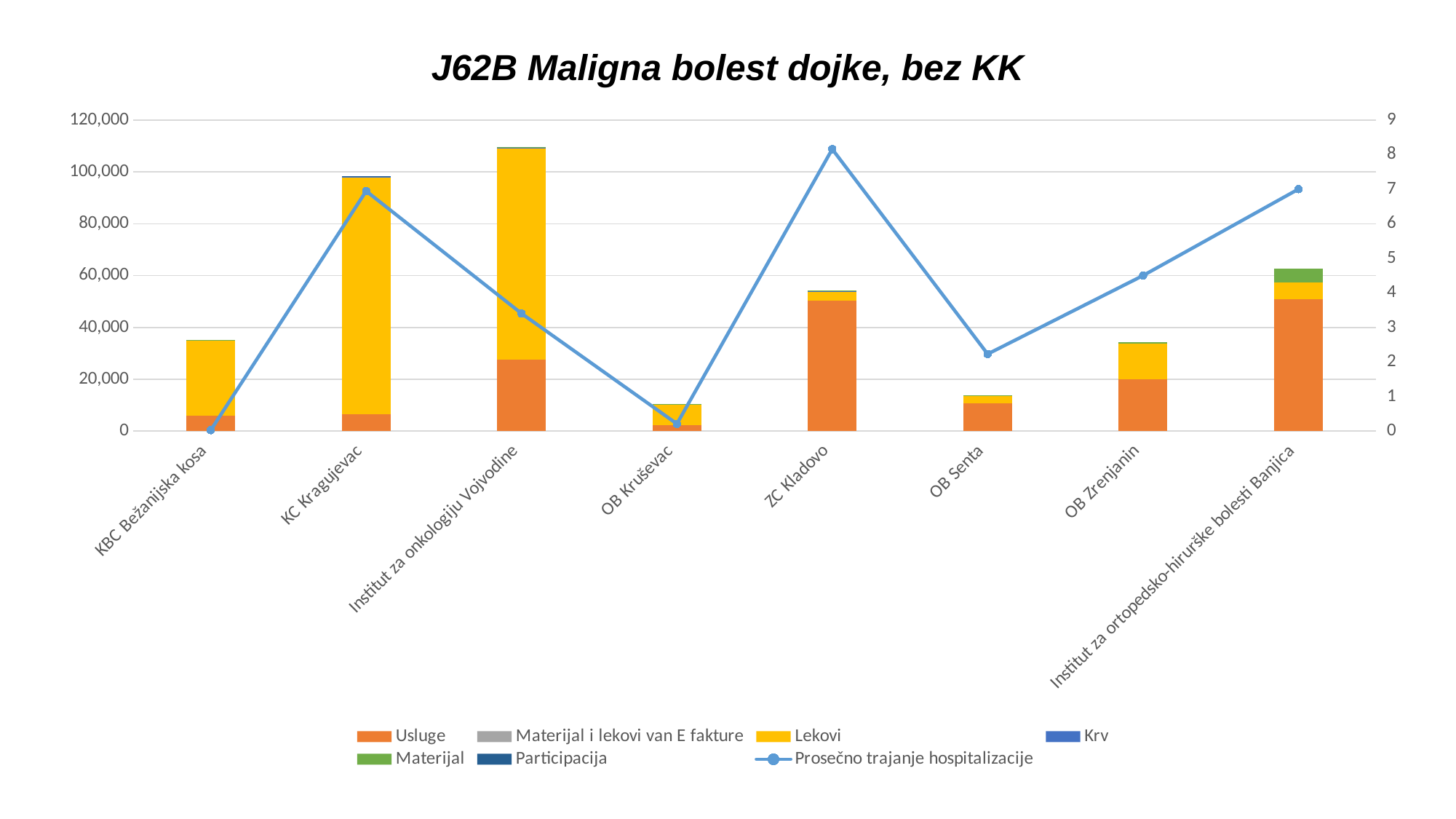
Which has the larger Usluge segment, ZC Kladovo or KC Kragujevac? ZC Kladovo What is the title of the chart? J62B Maligna bolest dojke, bez KK Is the Prosečno trajanje hospitalizacije value for ZC Kladovo greater or less than 7? greater How many categories (institutions) are shown on the x axis? 8 Is the total stacked bar for KC Kragujevac greater or less than 80,000? greater Which institution has the tallest stacked bar? Institut za onkologiju Vojvodine Which institution has the lowest value on the Prosečno trajanje hospitalizacije line? KBC Bežanijska kosa Which institution has the shortest stacked bar? OB Kruševac Which institution has the highest value on the Prosečno trajanje hospitalizacije line? ZC Kladovo Is the total stacked bar for OB Senta greater or less than 20,000? less How many series does the legend list? 7 What kind of chart is this? Stacked bar chart with a line